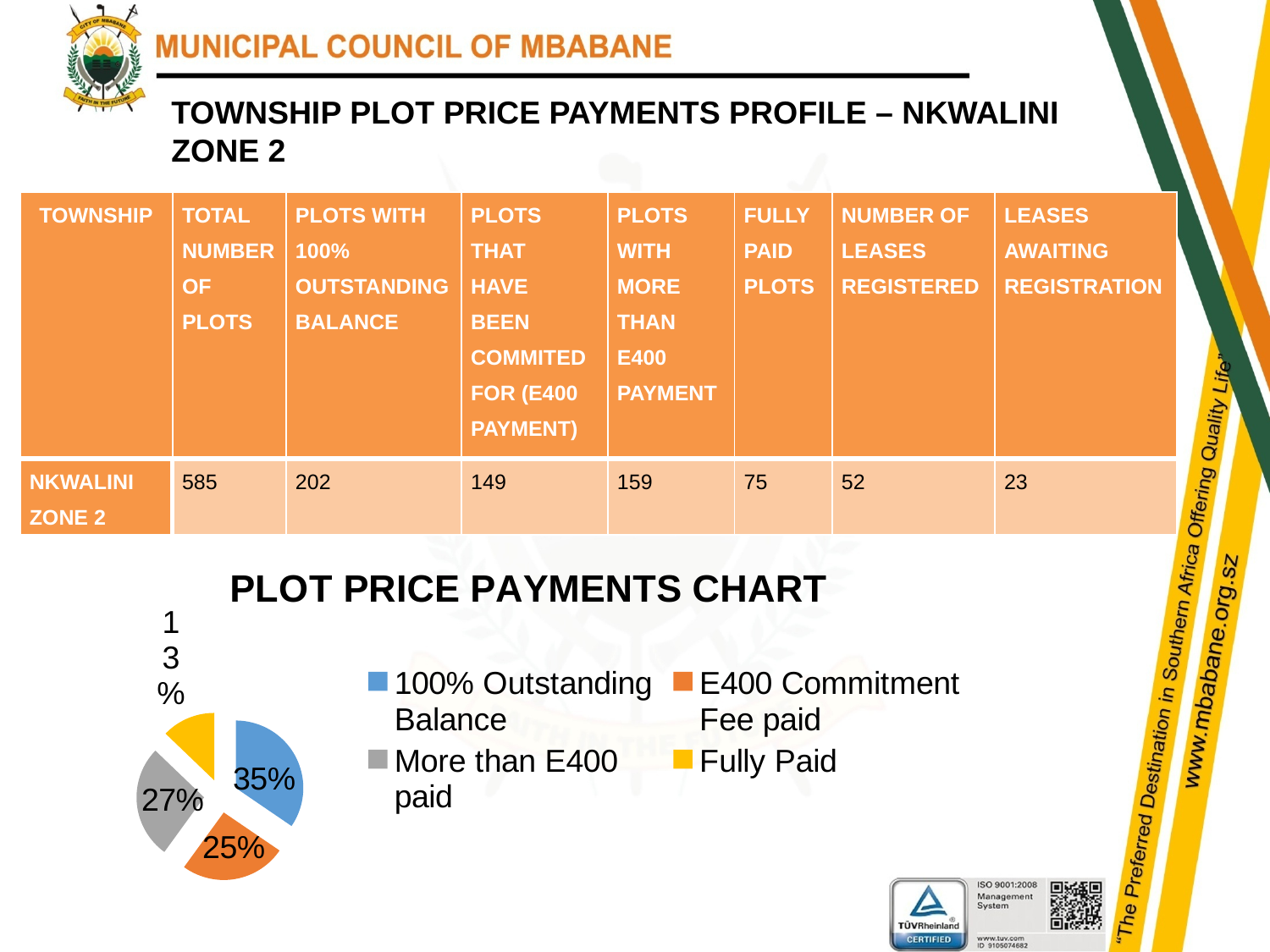
In the pie chart, what percentage is shown for 100% Outstanding Balance? 35% What colour is the Fully Paid slice in the pie chart? yellow In the pie chart, what percentage is shown for More than E400 paid? 27% How many slices does the pie chart have? 4 Which category has the smallest slice in the pie chart? Fully Paid What type of chart is shown under the title "PLOT PRICE PAYMENTS CHART"? pie chart How many entries does the legend of the pie chart list? 4 In the pie chart, what percentage is shown for E400 Commitment Fee paid? 25% Which category has the largest slice in the pie chart? 100% Outstanding Balance In the pie chart, which is larger: More than E400 paid or E400 Commitment Fee paid? More than E400 paid In the pie chart, what is the difference in percentage points between 100% Outstanding Balance and Fully Paid? 22 In the pie chart, what percentage is shown for Fully Paid? 13%